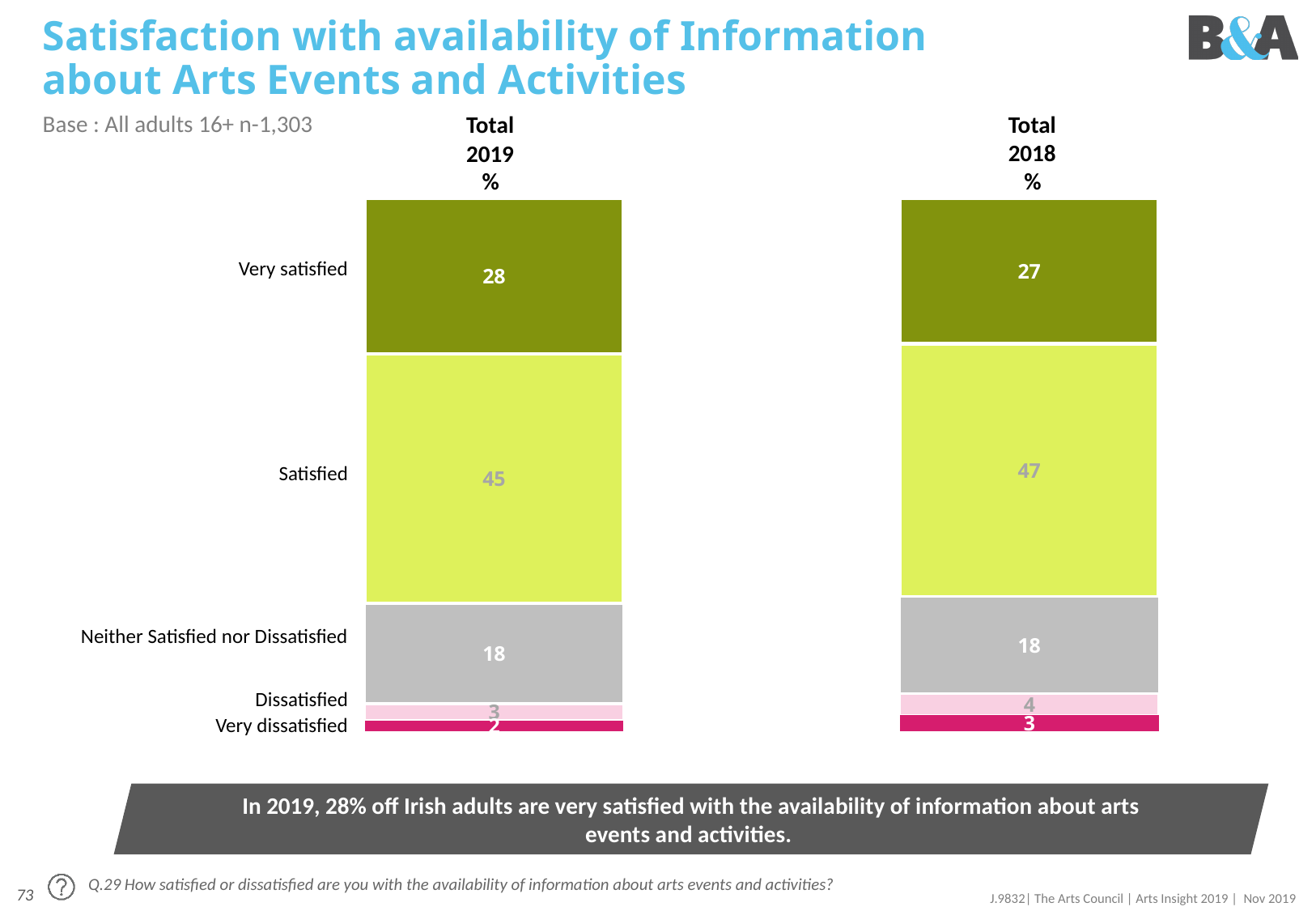
What percentage of adults were satisfied in Total 2018? 47 What is the difference between the Satisfied values for 2018 and 2019? 2 Which category has the smallest share in the Total 2019 bar? Very dissatisfied Is the Very satisfied value higher in Total 2019 or Total 2018? Total 2019 Which category has the largest share in the Total 2019 bar? Satisfied What is the value for Neither Satisfied nor Dissatisfied in the Total 2019 bar? 18 What percentage of adults were very satisfied in Total 2019? 28 What is the difference between the Dissatisfied values for 2018 and 2019? 1 How many satisfaction categories are shown in each bar? 5 What is the value for Very dissatisfied in the Total 2018 bar? 3 How many bars are shown on the chart? 2 What kind of chart is shown on the slide? Stacked bar chart